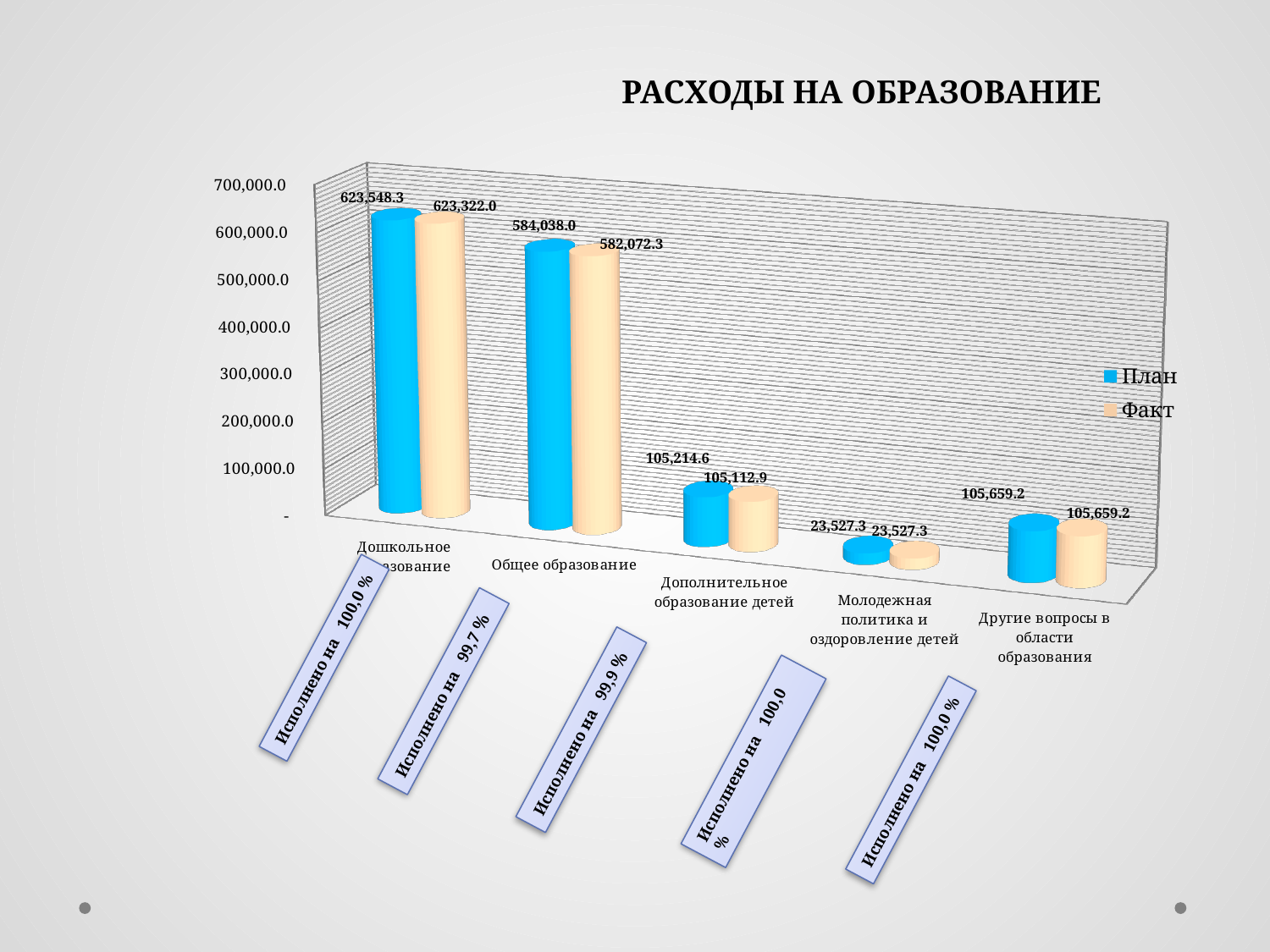
What is the План value for Дошкольное образование? 623,548.3 Which series are listed in the legend? План, Факт Which category has the highest План value? Дошкольное образование What is the Факт value for Молодежная политика и оздоровление детей? 23,527.3 What is the difference between the План and Факт values for Общее образование? 1,965.7 Which category has the lowest Факт value? Молодежная политика и оздоровление детей What type of chart is shown on the slide? bar chart How many categories are shown on the x axis? 5 What is the Факт value for Общее образование? 582,072.3 Is the План value for Общее образование greater or less than 500,000.0? greater How many series does the legend list? 2 What is the title of the chart? РАСХОДЫ НА ОБРАЗОВАНИЕ